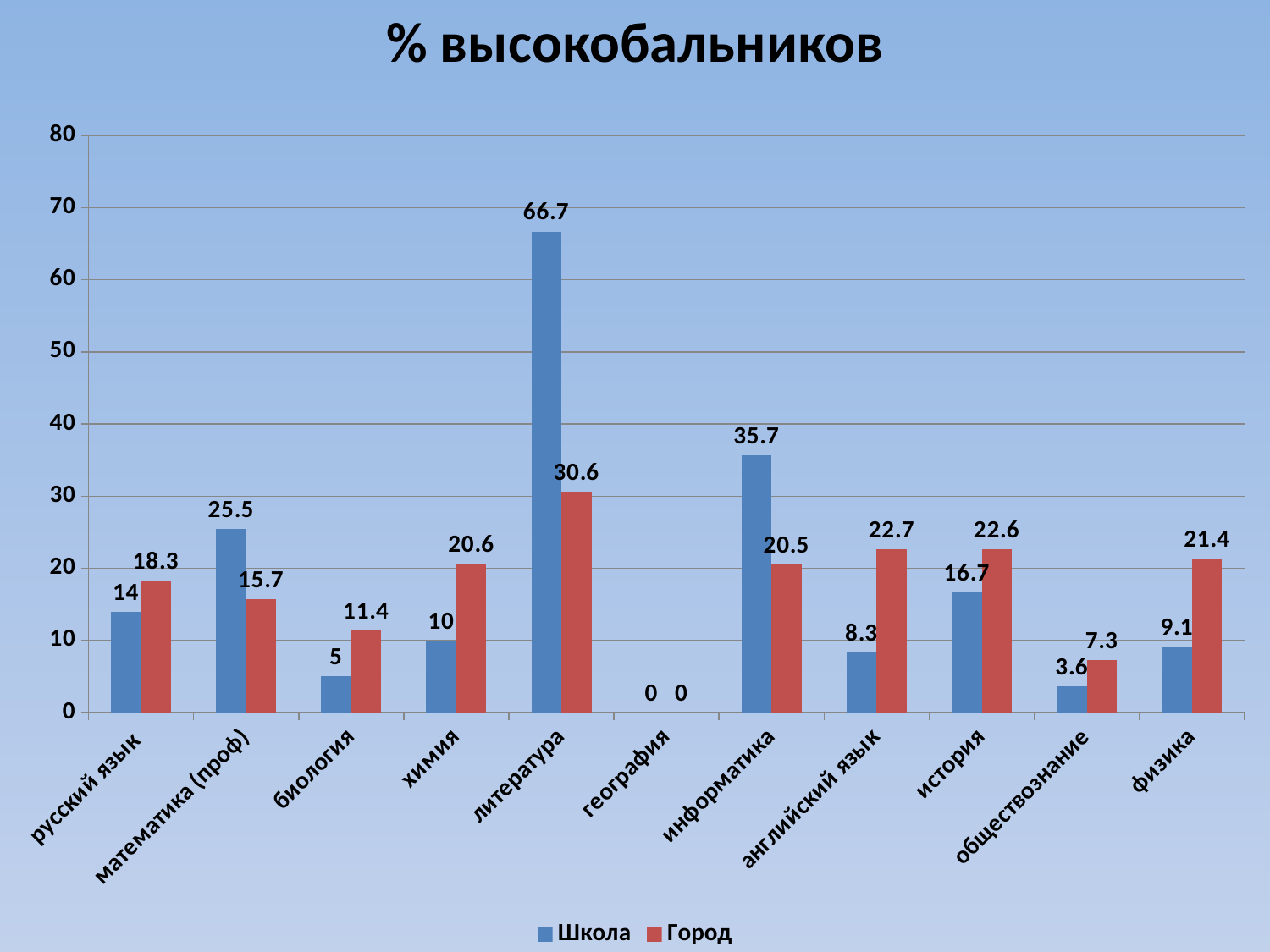
What kind of chart is this? bar chart What is the difference between the Школа and Город values for литература? 36.1 What is the value for Город in химия? 20.6 Which is larger for информатика: Школа or Город? Школа How many categories are shown on the x axis? 11 Which category has the highest Школа value? литература How many series does the legend list? 2 What is the value for Школа in обществознание? 3.6 Which category has the lowest Город value? география What is the value for Школа in литература? 66.7 Which is larger for физика: Школа or Город? Город What is the title of the chart? % высокобальников